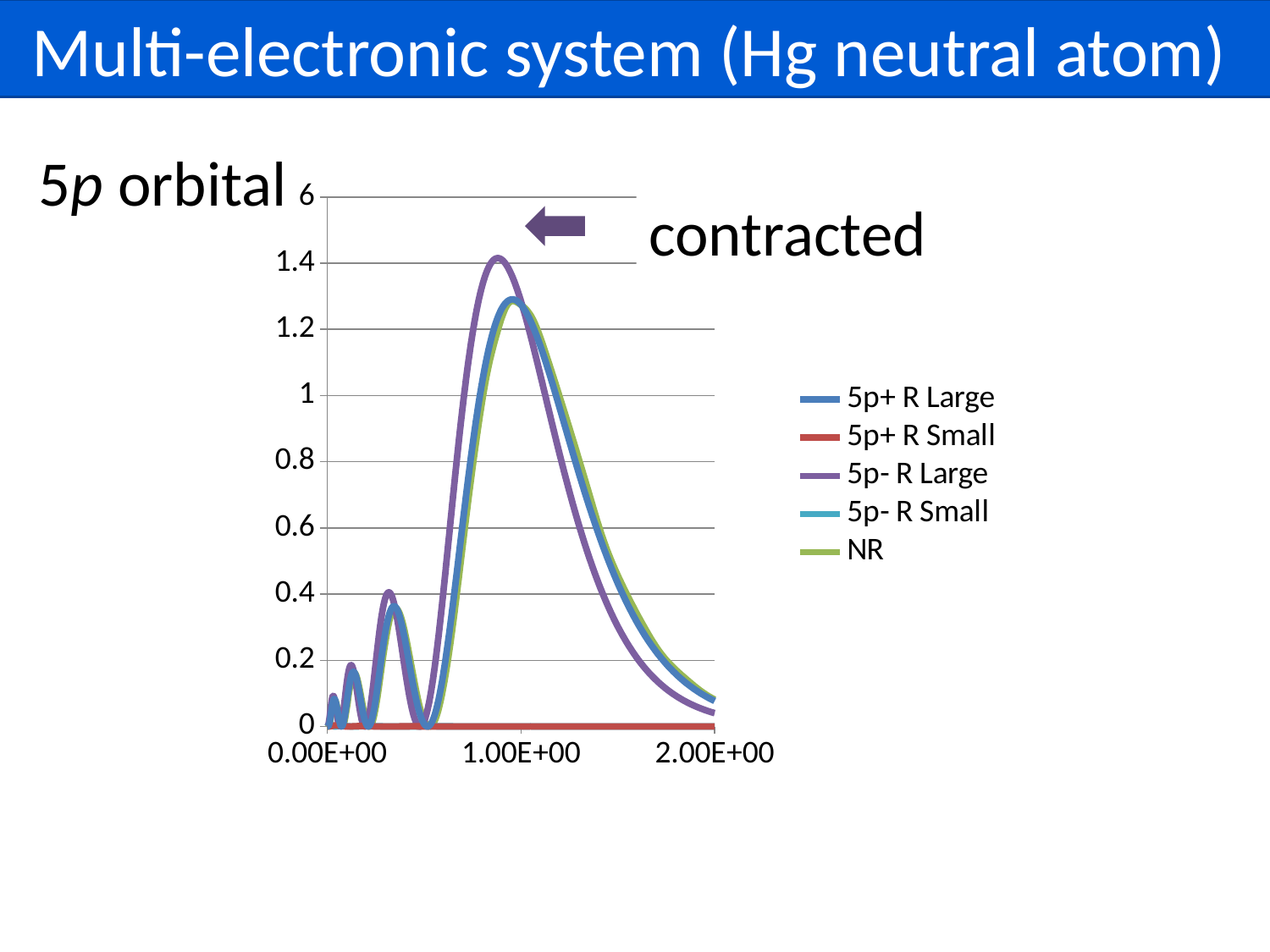
Which series has the larger peak, 5p- R Large or NR? 5p- R Large How many series does the legend list? 5 Is the peak value of the 5p- R Large series greater or less than 1.2? greater Is the peak value of the 5p+ R Large series greater or less than 1.4? less How many tick labels are shown on the x axis? 3 Is the value of the 5p+ R Small series at 1.00E+00 greater or less than 0.2? less What colour is the line for the 5p- R Large series? purple Which series stays lowest across the whole x-axis range? 5p+ R Small What kind of chart is shown on the slide? line chart What word is written next to the arrow above the chart? contracted Do the values of the 5p- R Large series rise or fall between 1.00E+00 and 2.00E+00 on the x axis? fall Which series reaches the highest peak value? 5p- R Large